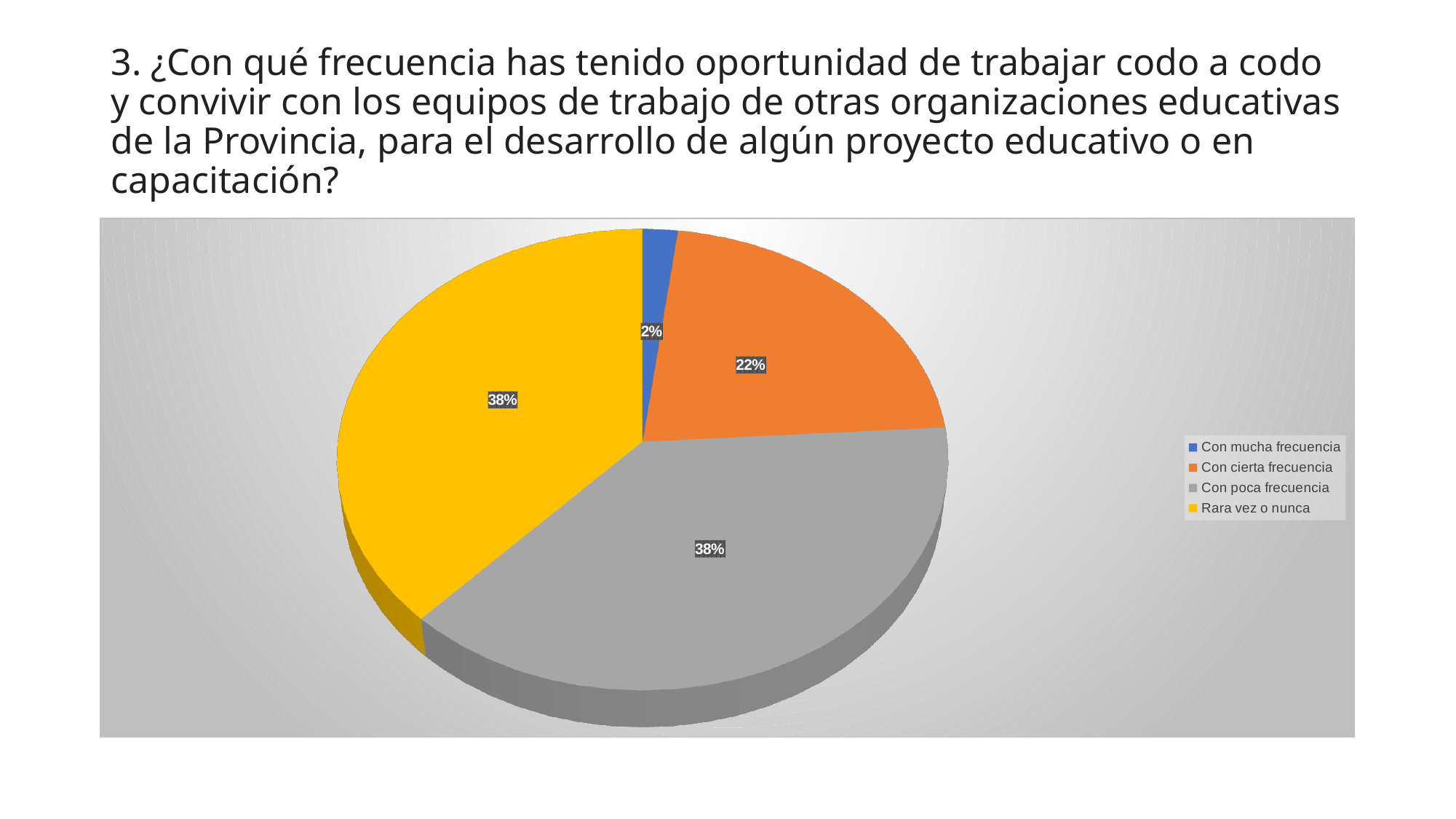
What kind of chart is shown on the slide? Pie chart What percentage of responses is 'Con cierta frecuencia'? 22% What percentage of responses is 'Con poca frecuencia'? 38% What percentage of responses is 'Con mucha frecuencia'? 2% Which is larger, the share for 'Con cierta frecuencia' or the share for 'Con mucha frecuencia'? Con cierta frecuencia What is the combined share of 'Con poca frecuencia' and 'Rara vez o nunca'? 76% What percentage of responses is 'Rara vez o nunca'? 38% Which category has the smallest share of the pie? Con mucha frecuencia How many entries does the legend list? 4 Which colour represents 'Rara vez o nunca' in the pie chart? Yellow How many categories does the pie chart show? 4 What is the difference in percentage points between 'Con poca frecuencia' and 'Con cierta frecuencia'? 16